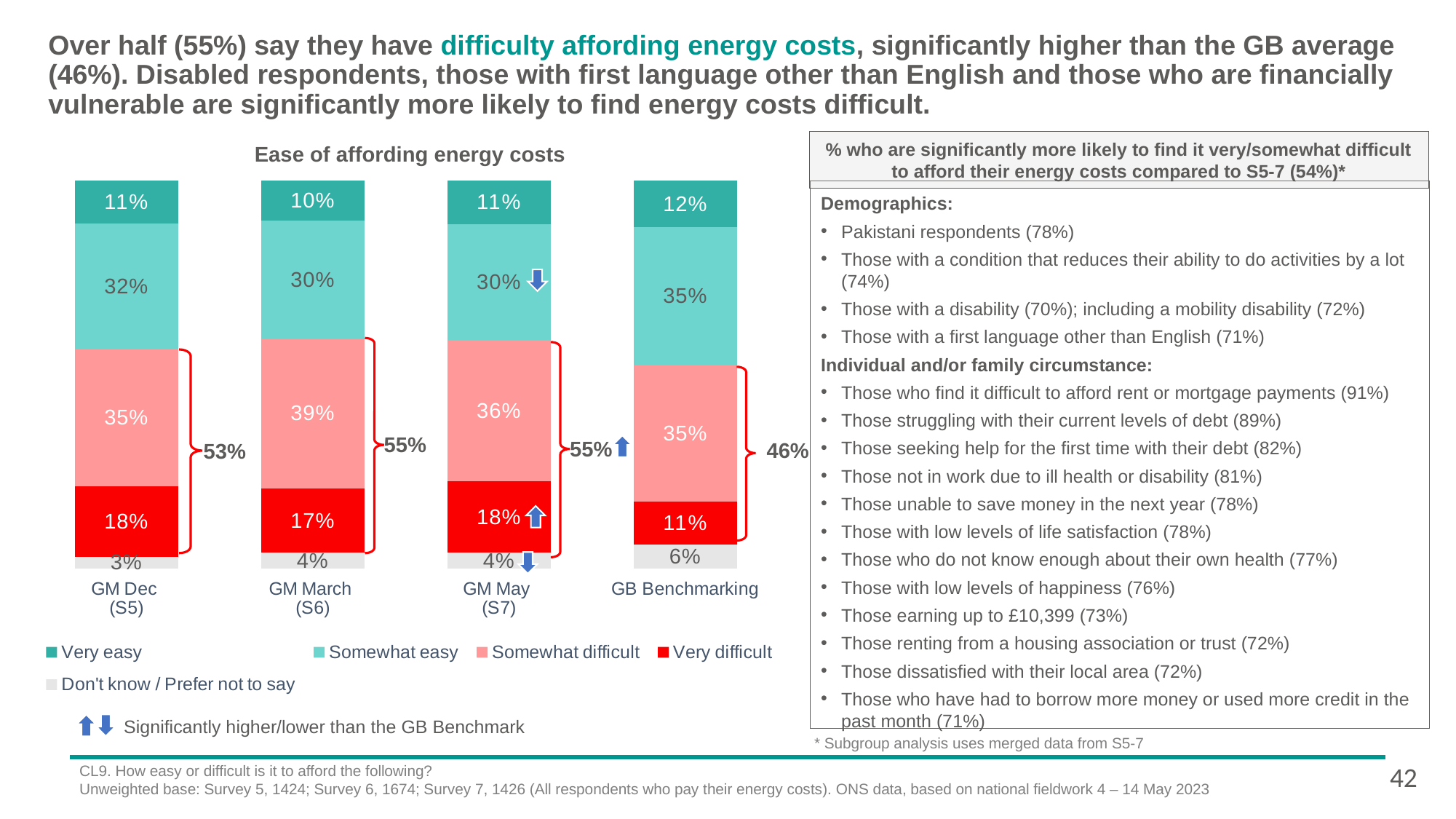
What is the 'Very difficult' value for GM May (S7)? 18% How many categories are shown along the x axis of the 'Ease of affording energy costs' chart? 4 Which is larger: the 'Somewhat easy' value for GM Dec (S5) or for GM March (S6)? GM Dec (S5) What is the difference between the 'Very difficult' values for GM Dec (S5) and GB Benchmarking? 7% What combined percentage of 'Somewhat difficult' and 'Very difficult' is shown by the bracket for GB Benchmarking? 46% What type of chart is 'Ease of affording energy costs'? Stacked bar chart Which category has the highest 'Somewhat difficult' value? GM March (S6) What is the 'Don't know / Prefer not to say' value for GM Dec (S5)? 3% What is the 'Somewhat difficult' value for GM March (S6)? 39% Which category has the lowest 'Very difficult' value? GB Benchmarking How many series does the legend of the 'Ease of affording energy costs' chart list? 5 What is the 'Somewhat easy' value for GB Benchmarking? 35%